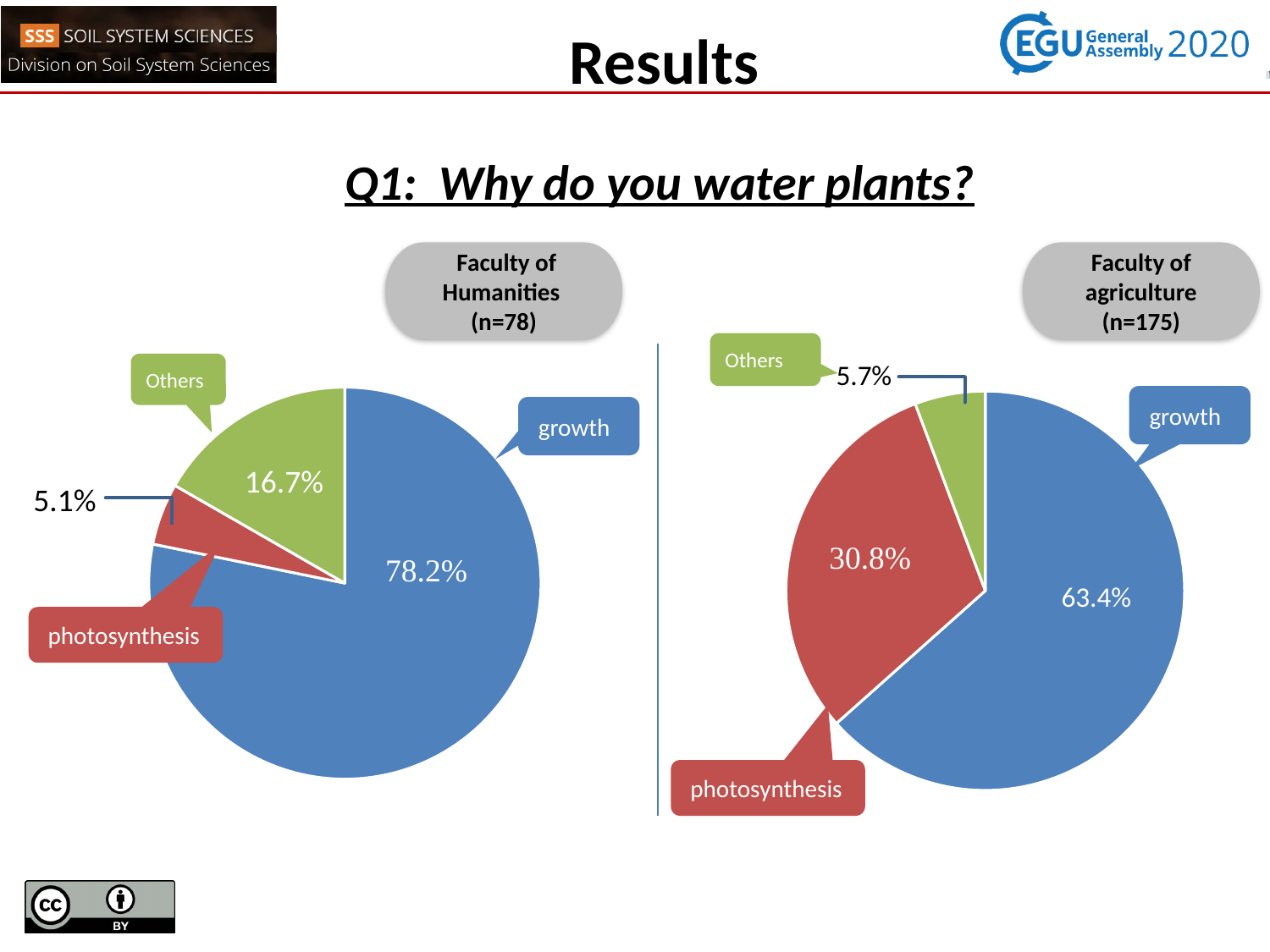
In the Faculty of Humanities pie chart, what share of respondents answered photosynthesis? 5.1% What is the difference between the growth share in the Faculty of Humanities pie chart and the growth share in the Faculty of agriculture pie chart? 14.8% In the Faculty of agriculture pie chart, what share of respondents answered growth? 63.4% In the Faculty of Humanities pie chart, what share of respondents answered growth? 78.2% In the Faculty of agriculture pie chart, what share is labelled Others? 5.7% In the Faculty of agriculture pie chart, what share of respondents answered photosynthesis? 30.8% How many slices does the Faculty of agriculture pie chart have? 3 In the Faculty of Humanities pie chart, which answer has the smallest share? photosynthesis Which is larger: the photosynthesis share in the Faculty of Humanities pie chart or the photosynthesis share in the Faculty of agriculture pie chart? Faculty of agriculture In the Faculty of Humanities pie chart, what share is labelled Others? 16.7% In the Faculty of agriculture pie chart, which answer has the largest share? growth What kind of chart is used for the Faculty of Humanities data? Pie chart